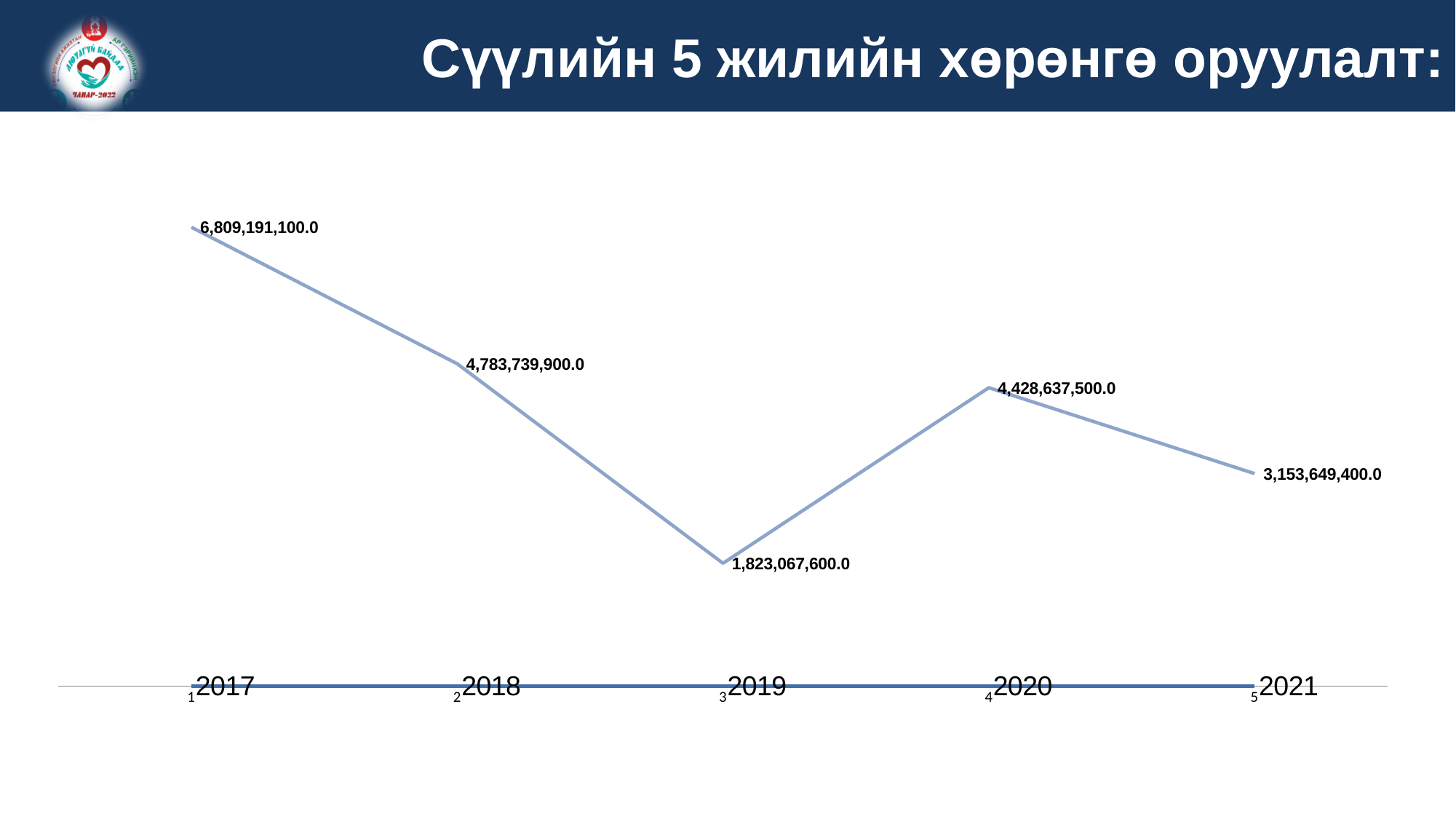
What kind of chart is shown on the slide? line chart What is the value for 2021? 3,153,649,400.0 What is the value for 2017? 6,809,191,100.0 What is the difference between the values for 2020 and 2021? 1,274,988,100.0 What is the value for 2019? 1,823,067,600.0 Which year has the lowest value? 2019 Do the values rise or fall from 2017 to 2019? fall Which is larger, the value for 2018 or the value for 2020? 2018 What is the difference between the values for 2017 and 2018? 2,025,451,200.0 What is the value for 2020? 4,428,637,500.0 How many years are plotted on the chart? 5 Which year has the highest value? 2017